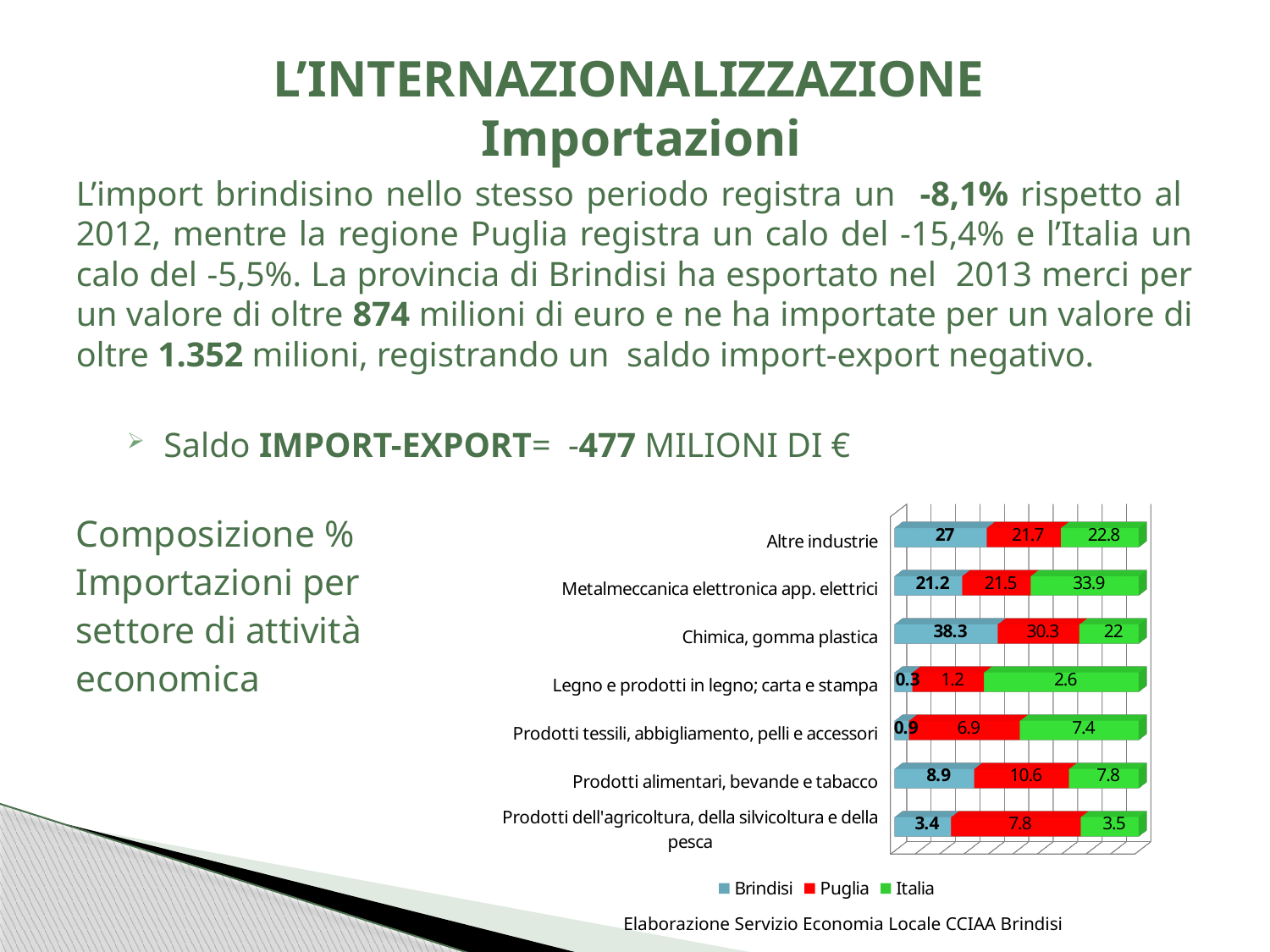
Which sector has the highest Brindisi value? Chimica, gomma plastica How many sectors (categories) are shown in the chart? 7 What is the Italia value for 'Metalmeccanica elettronica app. elettrici'? 33.9 Which sector has the lowest Italia value? Legno e prodotti in legno; carta e stampa Which series is shown in red in the chart? Puglia For 'Altre industrie', which is larger: the Brindisi value or the Italia value? Brindisi What is the Puglia value for 'Prodotti alimentari, bevande e tabacco'? 10.6 What type of chart is shown on the slide? Stacked bar chart What is the Brindisi value for 'Prodotti dell'agricoltura, della silvicoltura e della pesca'? 3.4 What is the Brindisi value for 'Chimica, gomma plastica'? 38.3 How many series does the chart legend list? 3 What is the difference between the Brindisi and Puglia values for 'Chimica, gomma plastica'? 8